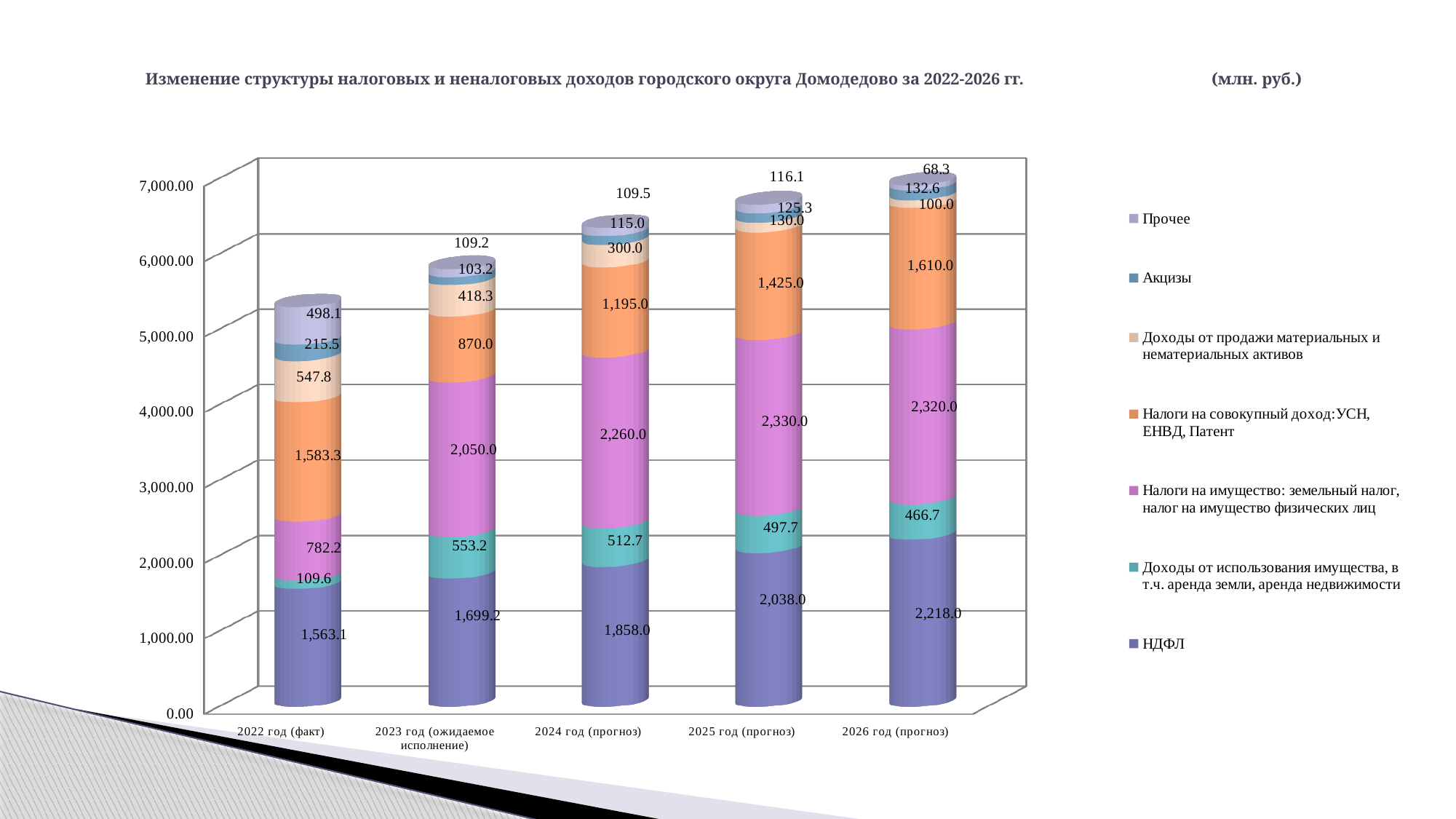
Does the НДФЛ value rise or fall from 2022 to 2026? Rises What is the total of the stacked bar for 2022 год (факт)? 5,299.6 What is the value of Акцизы for 2024 год (прогноз)? 115.0 In which year is the НДФЛ value the highest? 2026 год (прогноз) In which year is the Прочее value the lowest? 2026 год (прогноз) What kind of chart is shown on the slide? Stacked bar chart What is the value of НДФЛ for 2022 год (факт)? 1,563.1 For 2024 год (прогноз), which is larger: Налоги на имущество or Налоги на совокупный доход? Налоги на имущество What is the difference between the НДФЛ values for 2026 год (прогноз) and 2022 год (факт)? 654.9 How many years (categories) are shown on the x axis? 5 How many series does the legend list? 7 What is the value of Налоги на совокупный доход: УСН, ЕНВД, Патент for 2026 год (прогноз)? 1,610.0